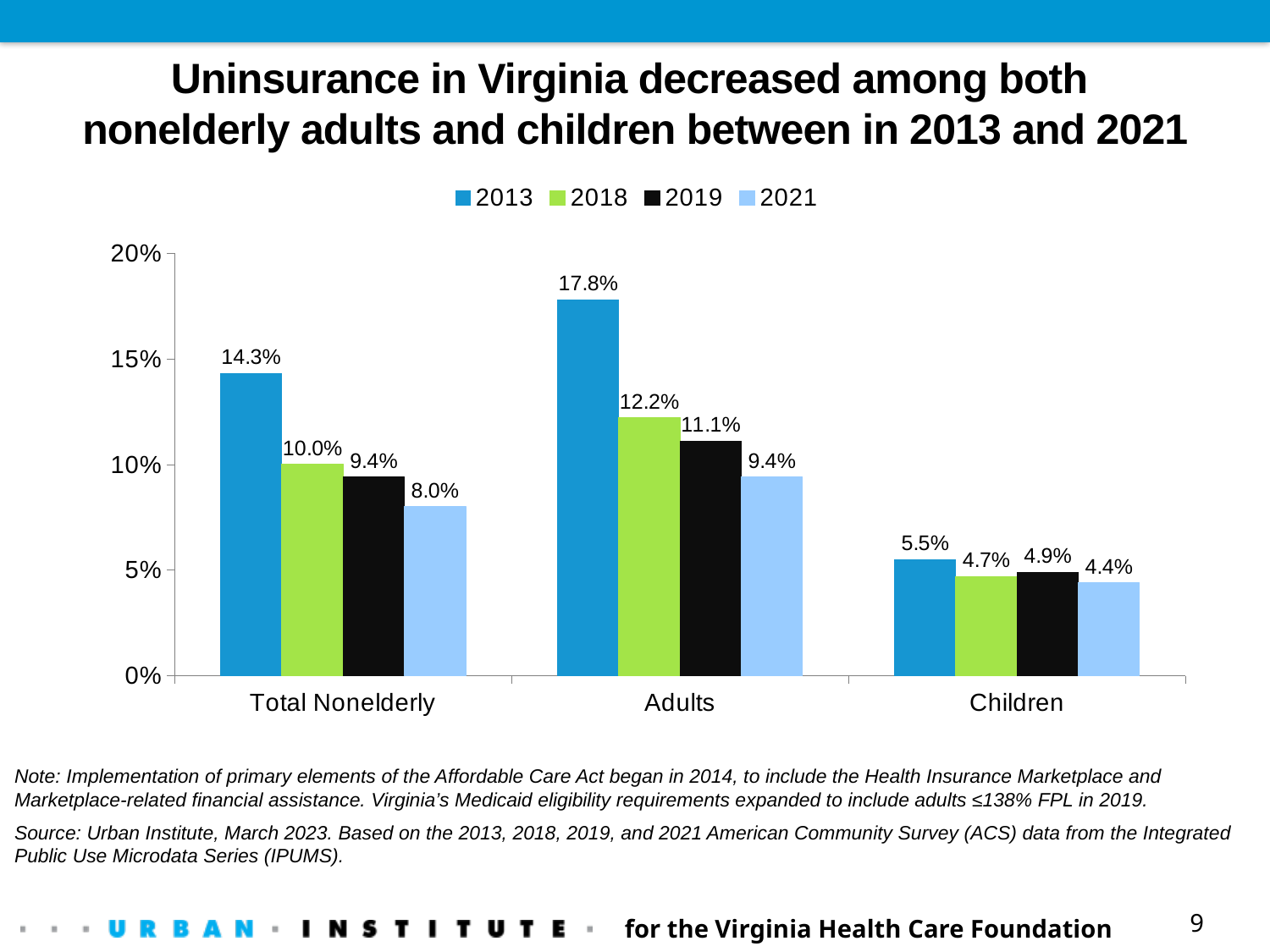
Which category had the highest uninsurance rate in 2013? Adults What kind of chart is shown on the slide? Bar chart Which category had the lowest uninsurance rate in 2021? Children How many years does the legend list? 4 What was the uninsurance rate for Adults in 2013? 17.8% Which was larger, the 2019 uninsurance rate for Adults or the 2019 rate for Total Nonelderly? Adults What was the uninsurance rate for Children in 2021? 4.4% What was the uninsurance rate for Total Nonelderly in 2018? 10.0% What is the difference between the 2013 and 2021 uninsurance rates for Total Nonelderly? 6.3 percentage points By how many percentage points did the uninsurance rate for Adults fall between 2013 and 2021? 8.4 percentage points How many categories are shown on the x axis? 3 Which colour represents 2021 in the chart? Light blue